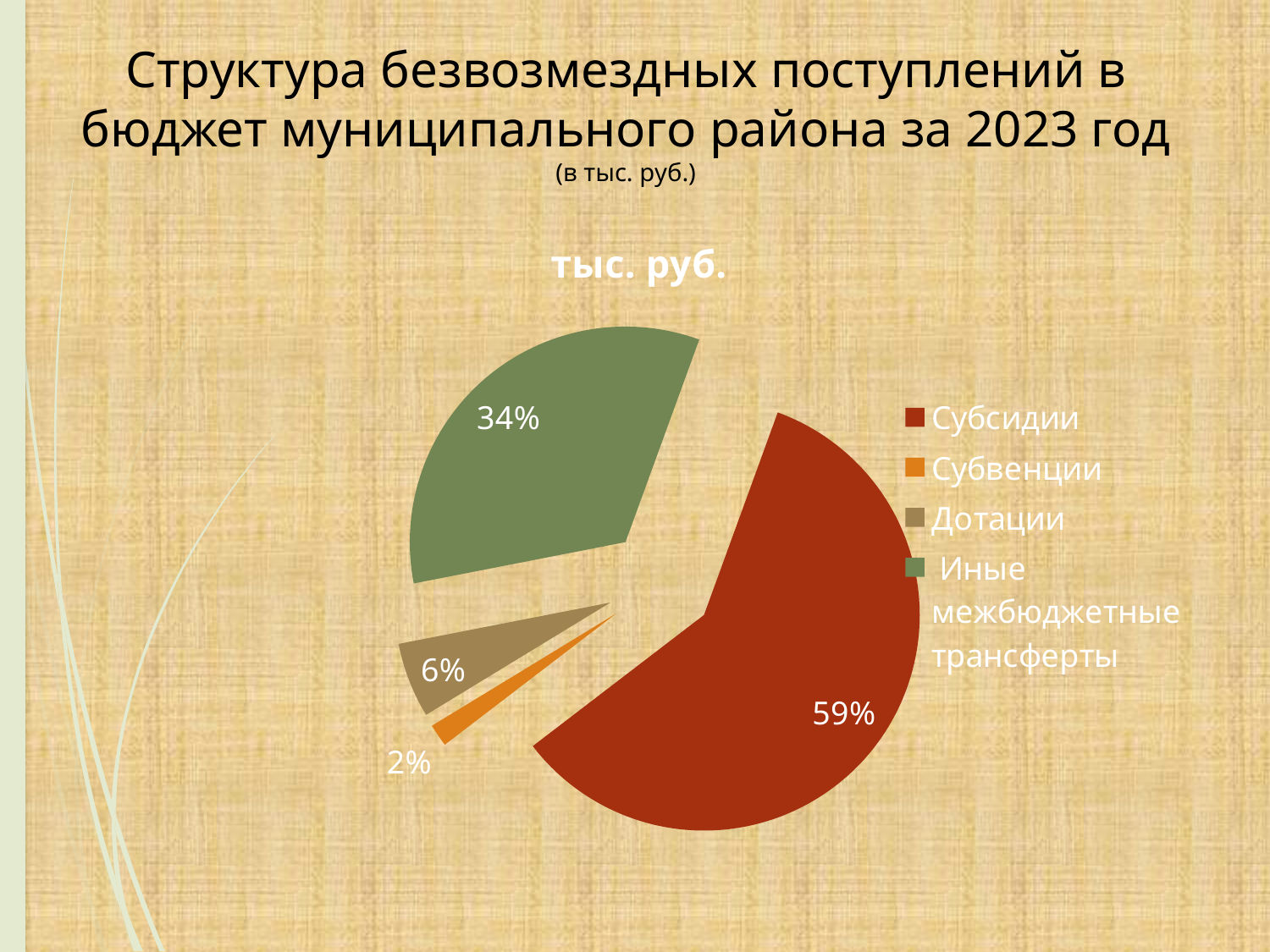
What share of the pie does Субвенции have? 2% What is the title of the chart? тыс. руб. What colour is the slice for Субвенции? orange Which is larger, the share for Дотации or the share for Субвенции? Дотации What is the difference in percentage points between Субсидии and Иные межбюджетные трансферты? 25 What share of the pie does Иные межбюджетные трансферты have? 34% Which category has the largest slice of the pie? Субсидии What share of the pie does Дотации have? 6% How many slices does the pie chart have? 4 Which category has the smallest slice of the pie? Субвенции What kind of chart is shown on the slide? pie chart